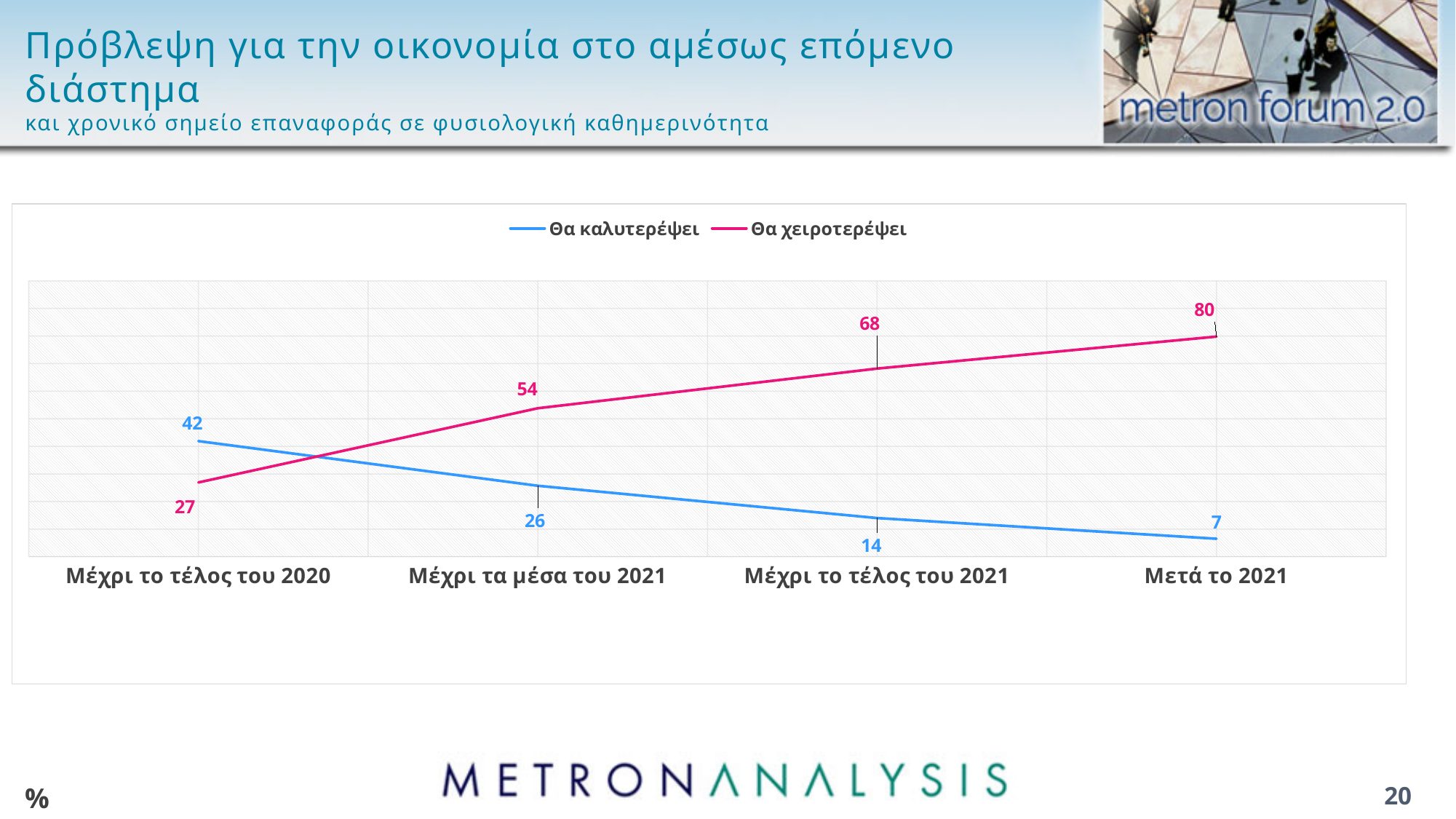
What is the value of the 'Θα καλυτερέψει' series for 'Μέχρι το τέλος του 2020'? 42 For 'Μέχρι το τέλος του 2020', which series has the larger value, 'Θα καλυτερέψει' or 'Θα χειροτερέψει'? Θα καλυτερέψει What is the value of the 'Θα καλυτερέψει' series for 'Μέχρι το τέλος του 2021'? 14 What is the value of the 'Θα χειροτερέψει' series for 'Μετά το 2021'? 80 For which category is the 'Θα χειροτερέψει' series highest? Μετά το 2021 What kind of chart is shown on the slide? Line chart For which category is the 'Θα καλυτερέψει' series lowest? Μετά το 2021 What is the value of the 'Θα χειροτερέψει' series for 'Μέχρι τα μέσα του 2021'? 54 Does the 'Θα καλυτερέψει' series rise or fall along the x axis? Fall How many series does the legend list? 2 How many categories are shown on the x axis? 4 What is the difference between the 'Θα χειροτερέψει' and 'Θα καλυτερέψει' values for 'Μέχρι το τέλος του 2021'? 54